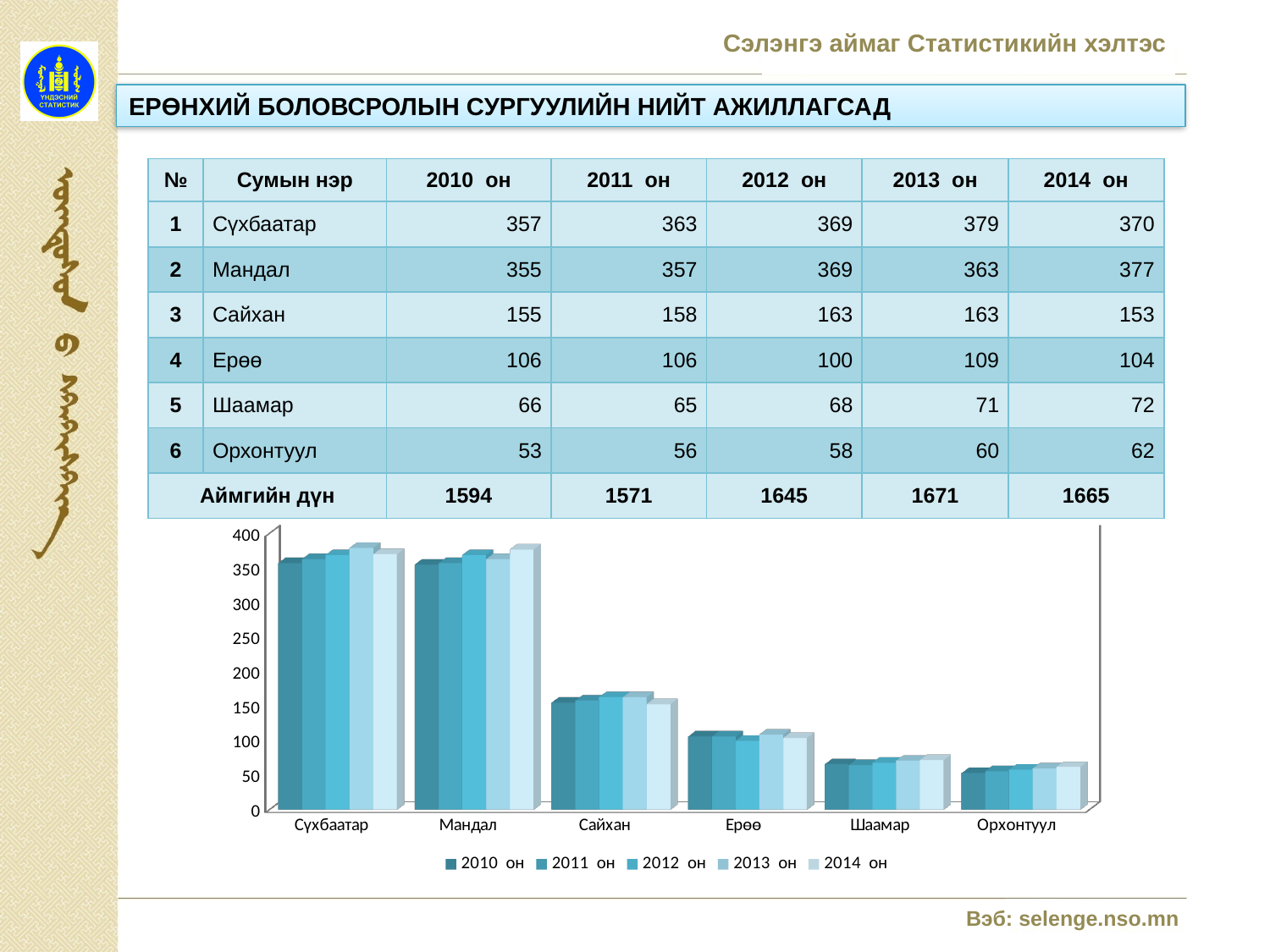
According to the slide, what is the value for Сүхбаатар in 2013 он? 379 According to the slide, what is the value for Орхонтуул in 2010 он? 53 Is the value for Сайхан in 2011 он greater or less than 200? less What kind of chart is shown on the slide? bar chart Which is larger, the 2012 он value for Ерөө or the 2012 он value for Шаамар? Ерөө Do the values for Орхонтуул rise or fall from 2010 он to 2014 он? rise What is the difference between the 2014 он values for Мандал and Сайхан? 224 What is the last series listed in the chart legend? 2014 он How many series does the chart legend list? 5 Which category has the lowest bars in the chart? Орхонтуул Which category has the highest value for 2013 он? Сүхбаатар How many sum categories are shown on the x axis of the chart? 6